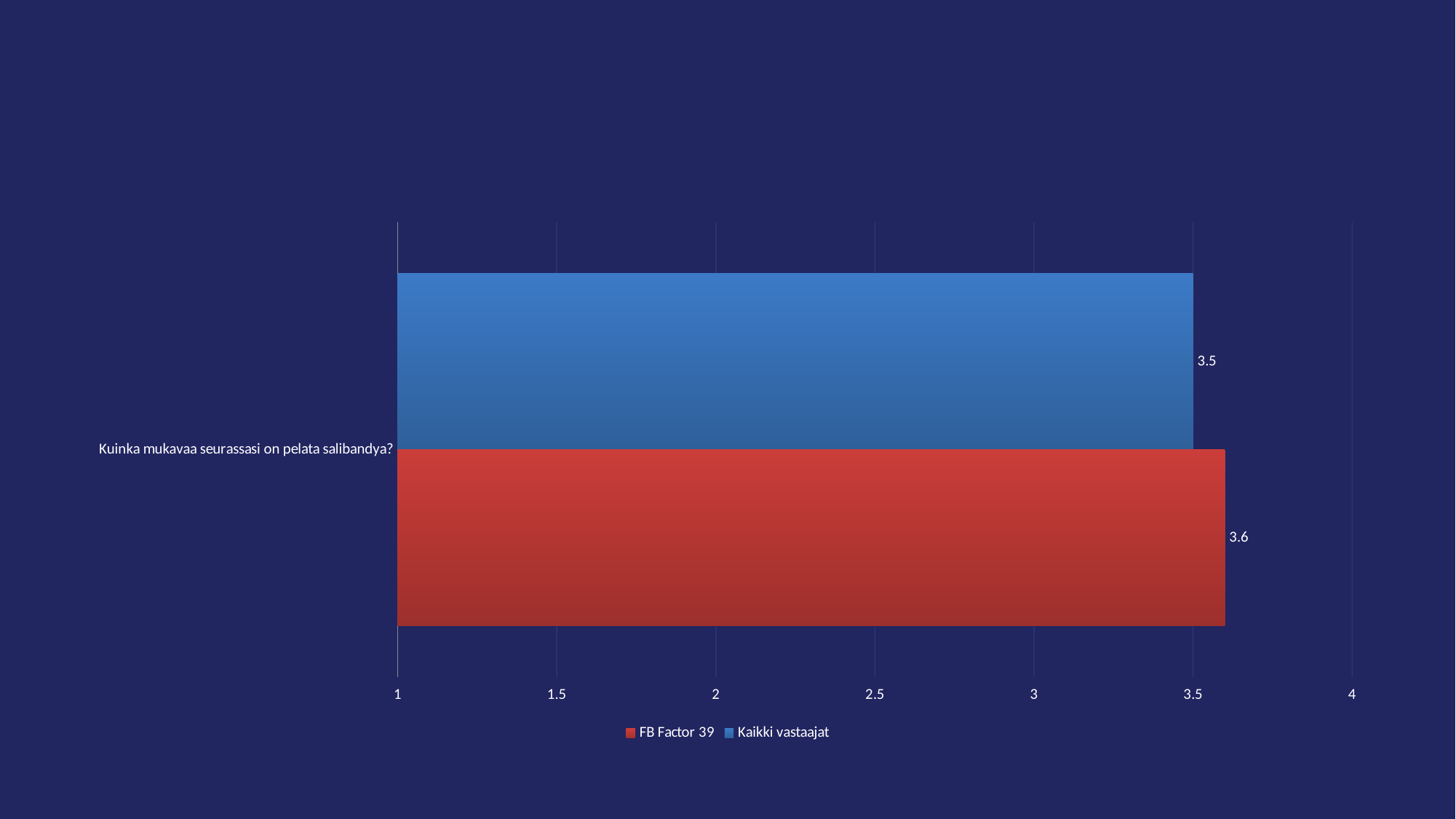
Which series has the lowest value on the chart? Kaikki vastaajat How many series does the legend list? 2 Is the value for Kaikki vastaajat greater or less than 4? less What is the category label shown on the chart? Kuinka mukavaa seurassasi on pelata salibandya? What kind of chart is shown on the slide? Bar chart How many categories are shown on the chart? 1 Which series has the higher value, FB Factor 39 or Kaikki vastaajat? FB Factor 39 What is the value for FB Factor 39 on the question "Kuinka mukavaa seurassasi on pelata salibandya?"? 3.6 What is the value for Kaikki vastaajat on the question "Kuinka mukavaa seurassasi on pelata salibandya?"? 3.5 What colour is the bar for FB Factor 39? Red Is the value for FB Factor 39 greater or less than 3? greater What is the difference between the FB Factor 39 value and the Kaikki vastaajat value? 0.1